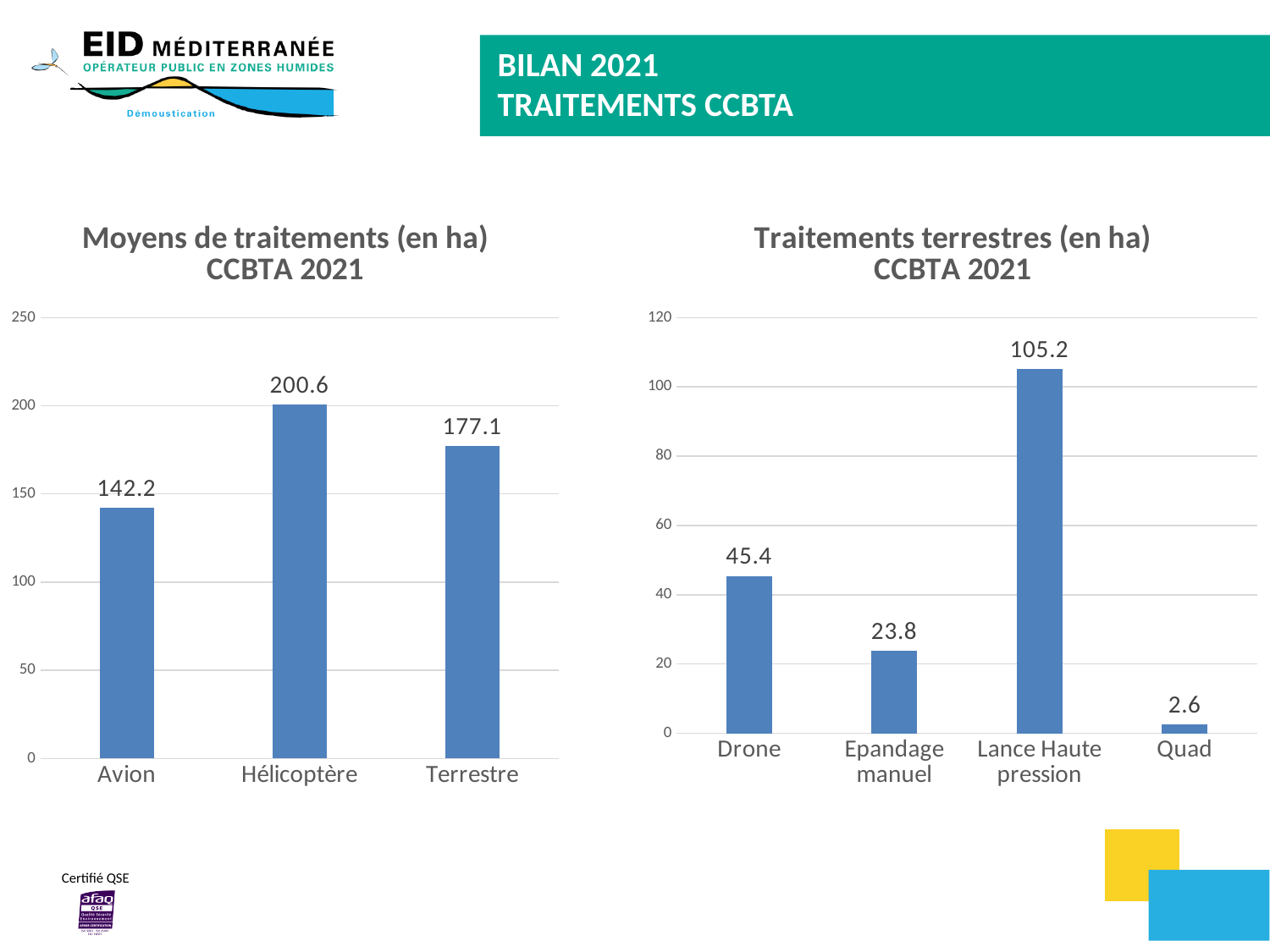
In the 'Moyens de traitements (en ha) CCBTA 2021' chart, what is the value for Hélicoptère? 200.6 In the 'Traitements terrestres (en ha) CCBTA 2021' chart, which category has the highest value? Lance Haute pression In the 'Traitements terrestres (en ha) CCBTA 2021' chart, how many categories are shown? 4 In the 'Moyens de traitements (en ha) CCBTA 2021' chart, how many categories are shown? 3 In the 'Traitements terrestres (en ha) CCBTA 2021' chart, what is the difference between Lance Haute pression and Quad? 102.6 What type of chart is the 'Traitements terrestres (en ha) CCBTA 2021' chart? Bar chart In the 'Traitements terrestres (en ha) CCBTA 2021' chart, which is larger, Drone or Epandage manuel? Drone In the 'Moyens de traitements (en ha) CCBTA 2021' chart, which category has the lowest value? Avion In the 'Moyens de traitements (en ha) CCBTA 2021' chart, is the value for Avion greater or less than 150? less In the 'Traitements terrestres (en ha) CCBTA 2021' chart, which category has the lowest value? Quad In the 'Moyens de traitements (en ha) CCBTA 2021' chart, what is the difference between Hélicoptère and Terrestre? 23.5 In the 'Traitements terrestres (en ha) CCBTA 2021' chart, what is the value for Drone? 45.4